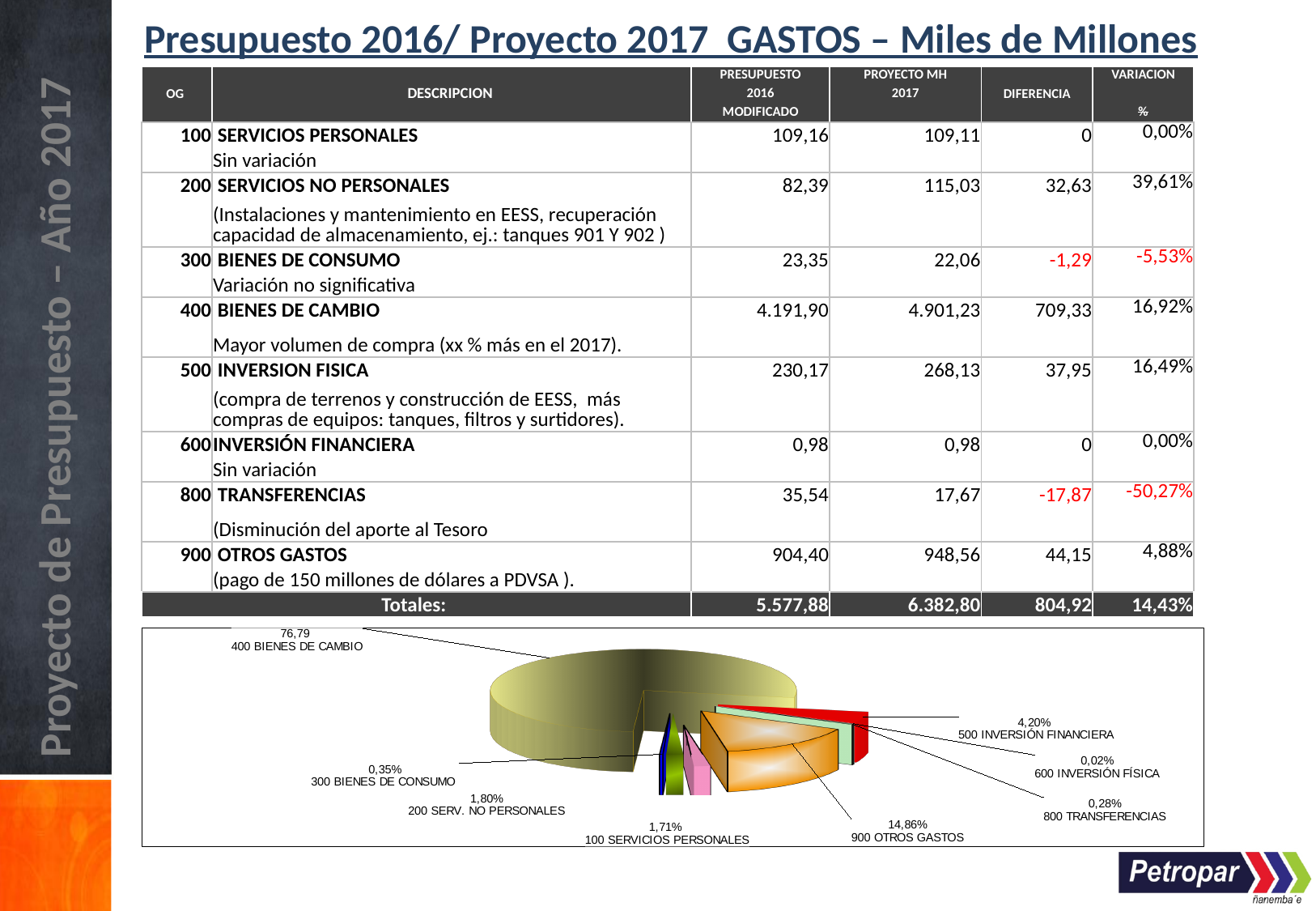
In the pie chart, which has the larger share: 900 OTROS GASTOS or 500 INVERSIÓN FINANCIERA? 900 OTROS GASTOS In the pie chart, what is the difference between the shares of 900 OTROS GASTOS and 500 INVERSIÓN FINANCIERA? 10,66% Which slice of the pie chart is the smallest? 600 INVERSIÓN FÍSICA In the pie chart, what share is labelled for 800 TRANSFERENCIAS? 0,28% How many slices does the pie chart have? 8 In the pie chart, what share is labelled for 300 BIENES DE CONSUMO? 0,35% What kind of chart is shown at the bottom of the slide? Pie chart In the pie chart, what share is labelled for 900 OTROS GASTOS? 14,86% Which slice of the pie chart is the largest? 400 BIENES DE CAMBIO